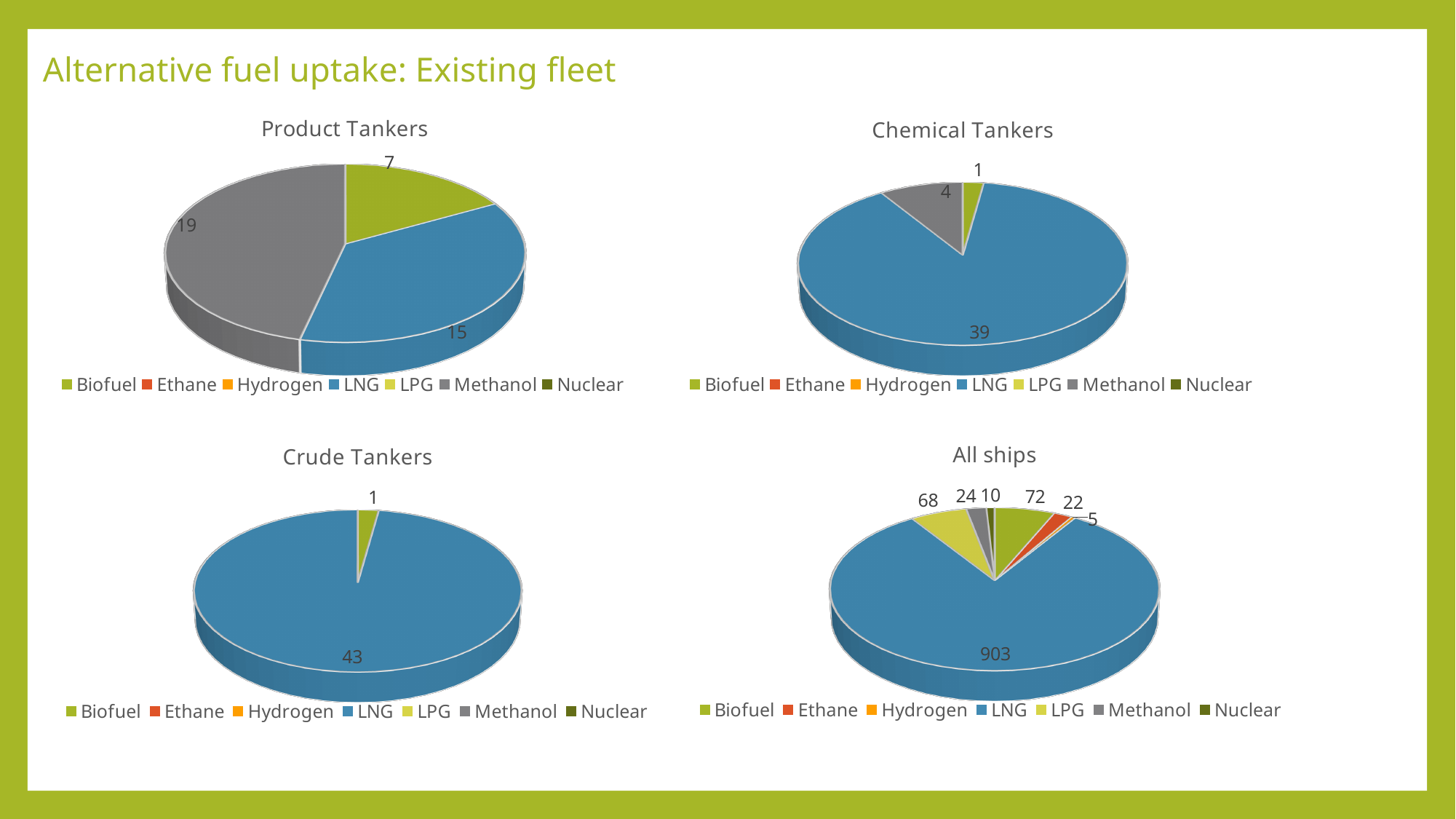
In the Chemical Tankers chart, what is the value for LNG? 39 In the All ships chart, what is the value for LPG? 68 In the Product Tankers chart, which fuel has the largest slice? Methanol How many fuel types does the legend of the All ships chart list? 7 In the Crude Tankers chart, what is the value for LNG? 43 In the All ships chart, what is the value for LNG? 903 In the Product Tankers chart, what is the value for Methanol? 19 In the All ships chart, which is larger, the Biofuel value or the Ethane value? Biofuel In the Crude Tankers chart, which fuel has the smallest slice? Biofuel In the Chemical Tankers chart, what is the value for Methanol? 4 In the Product Tankers chart, what is the value for LNG? 15 In the Product Tankers chart, what is the difference between the Methanol and Biofuel values? 12